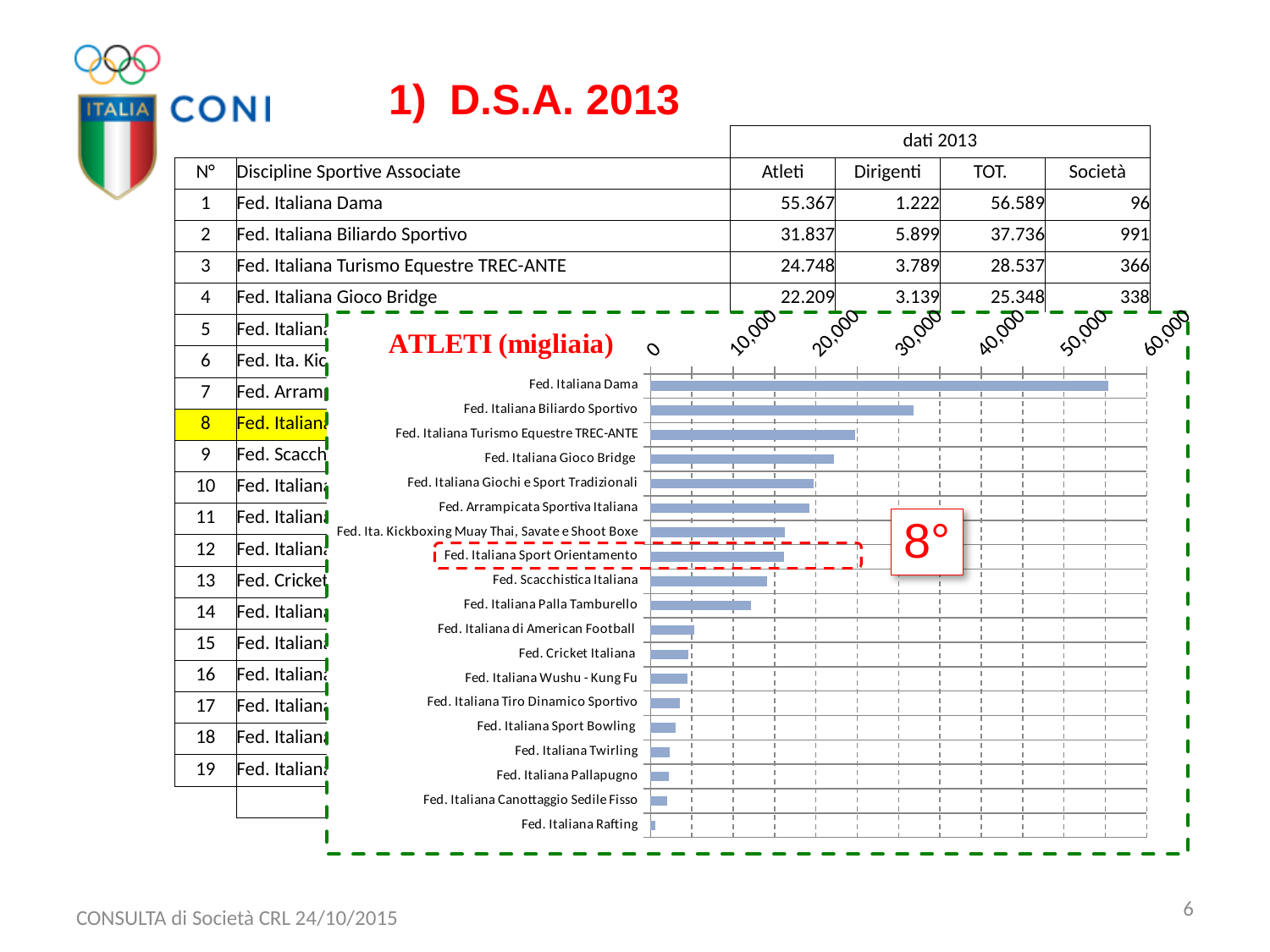
Which federation has the lowest value in the chart? Fed. Italiana Rafting How many federations (categories) are plotted in the chart? 19 Which is larger, the value for Fed. Italiana Turismo Equestre TREC-ANTE or for Fed. Italiana Gioco Bridge? Fed. Italiana Turismo Equestre TREC-ANTE Do the bar values increase or decrease going from the top of the chart to the bottom? decrease Is the value for Fed. Italiana Dama greater or less than 50,000? greater What is the title of the chart? ATLETI (migliaia) Which federation is highlighted with the red dashed box and the label 8° in the chart? Fed. Italiana Sport Orientamento Which federation has the highest value in the chart? Fed. Italiana Dama Is the value for Fed. Italiana di American Football greater or less than 10,000? less What kind of chart is shown on the slide? bar chart Is the value for Fed. Italiana Biliardo Sportivo greater or less than 30,000? greater